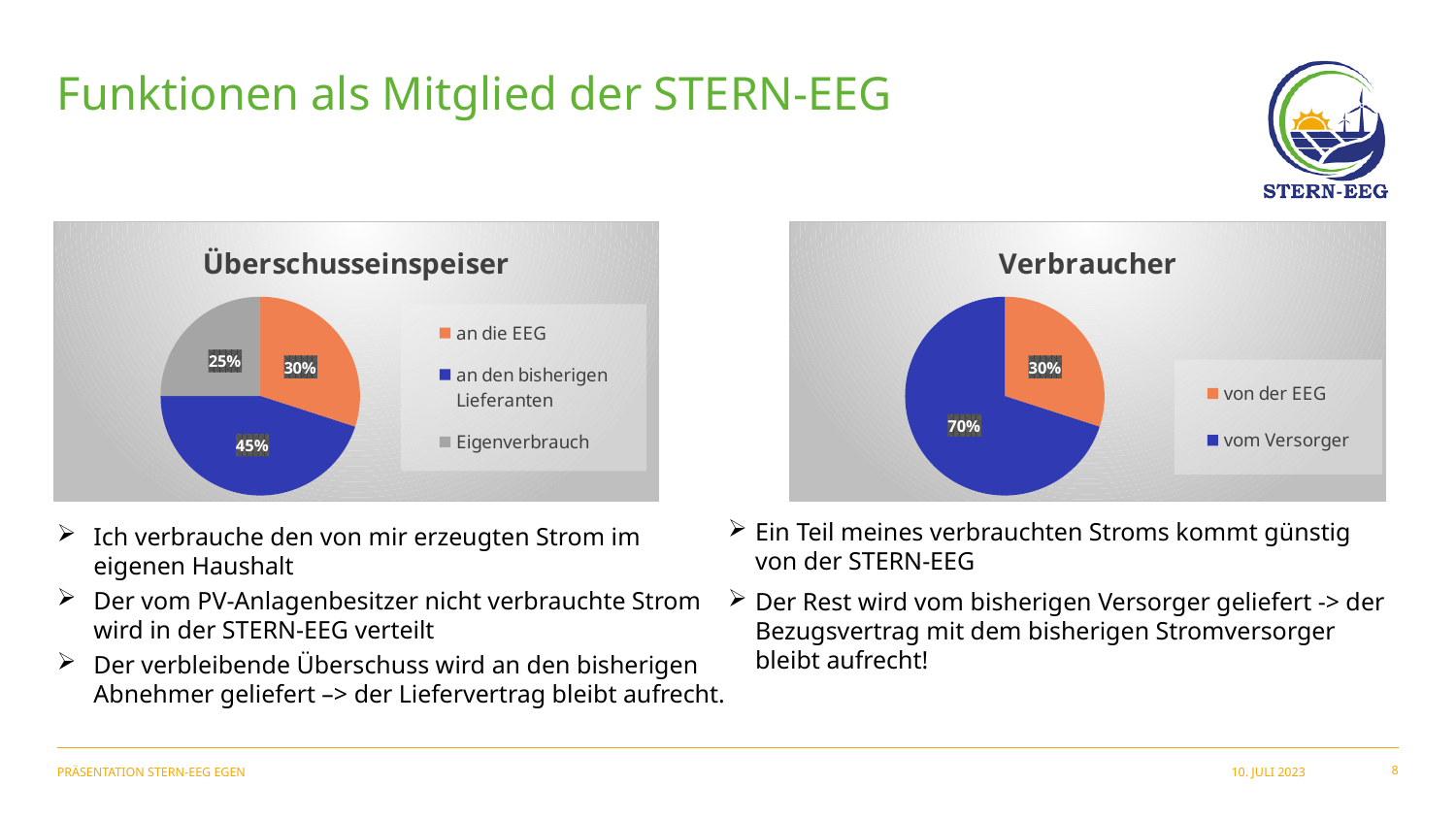
In the "Überschusseinspeiser" chart, how many categories does the legend list? 3 In the "Überschusseinspeiser" chart, what share goes to "an den bisherigen Lieferanten"? 45% In the "Überschusseinspeiser" chart, what share is "Eigenverbrauch"? 25% In the "Verbraucher" chart, which is larger: "von der EEG" or "vom Versorger"? vom Versorger In the "Überschusseinspeiser" chart, which category has the smallest share? Eigenverbrauch In the "Verbraucher" chart, what share comes "von der EEG"? 30% In the "Überschusseinspeiser" chart, which category has the largest share? an den bisherigen Lieferanten In the "Überschusseinspeiser" chart, what is the difference between the share for "an den bisherigen Lieferanten" and the share for "an die EEG"? 15% What type of chart is the "Verbraucher" chart? Pie chart In the "Verbraucher" chart, what share comes "vom Versorger"? 70% In the "Verbraucher" chart, what colour is the "vom Versorger" slice? Blue In the "Überschusseinspeiser" chart, what share goes to "an die EEG"? 30%